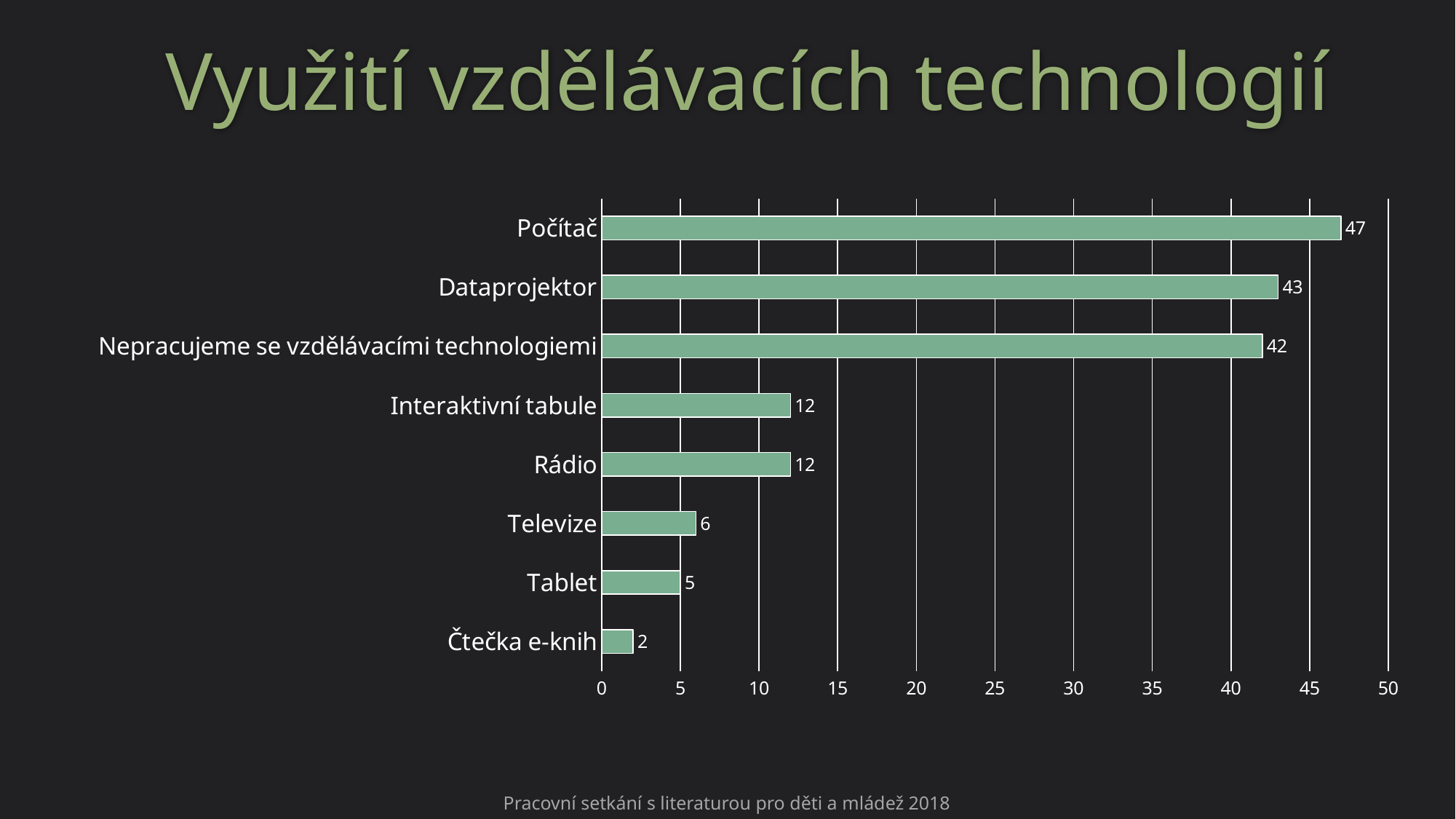
How many categories are shown in the chart? 8 What is the difference between the values for Interaktivní tabule and Tablet? 7 What is the value for Televize? 6 What is the value for Čtečka e-knih? 2 What is the difference between the values for Počítač and Dataprojektor? 4 Which is larger, the value for Nepracujeme se vzdělávacími technologiemi or the value for Rádio? Nepracujeme se vzdělávacími technologiemi What is the value for Počítač? 47 Which category has the lowest value? Čtečka e-knih What is the title of the slide? Využití vzdělávacích technologií Which category has the highest value? Počítač What kind of chart is shown on the slide? Bar chart What is the value for Dataprojektor? 43